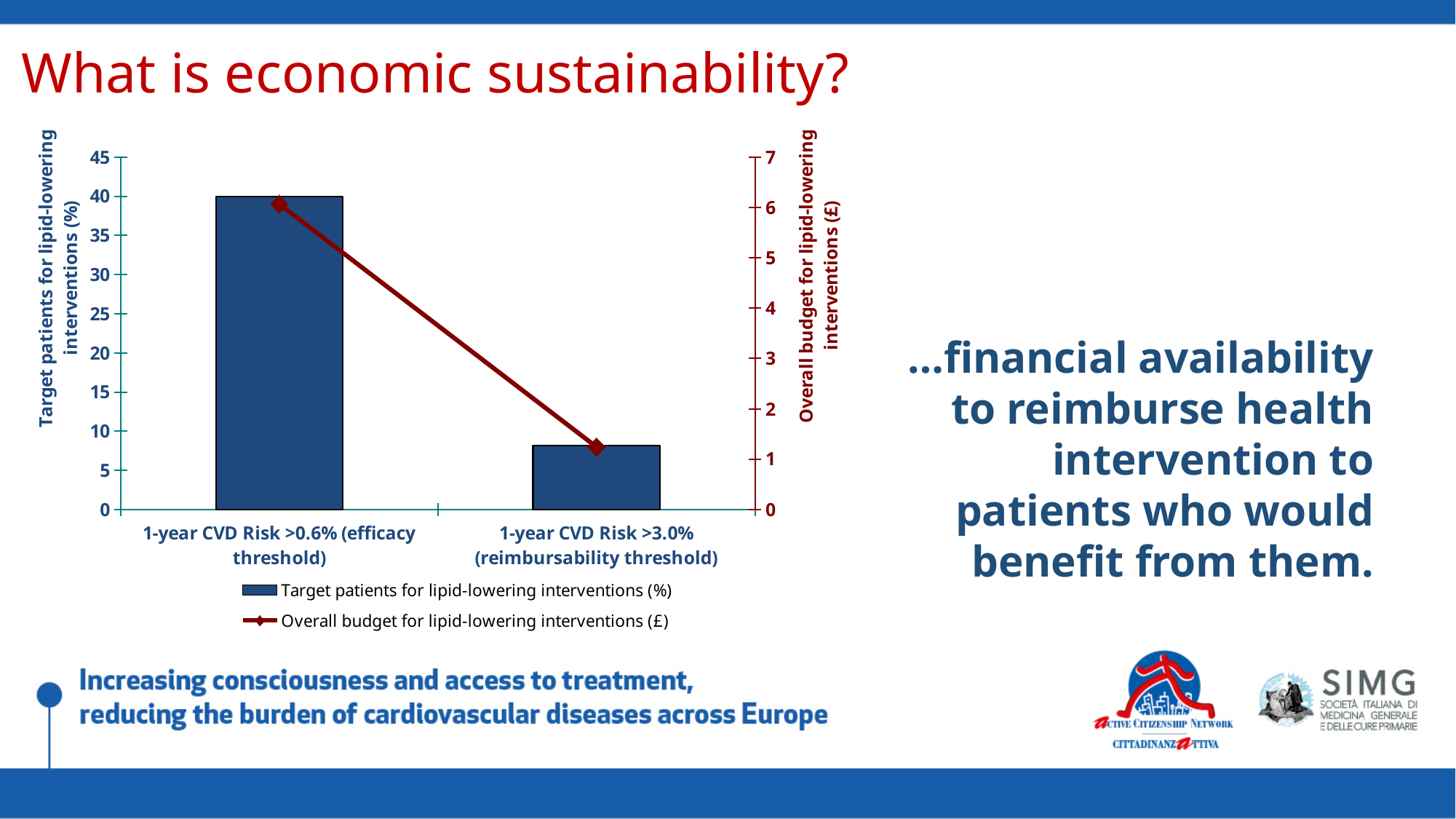
Which category has the highest Target patients for lipid-lowering interventions (%) value? 1-year CVD Risk >0.6% (efficacy threshold) Do the values of both series rise or fall from the >0.6% category to the >3.0% category? fall Is the Overall budget for lipid-lowering interventions (£) value for 1-year CVD Risk >3.0% (reimbursability threshold) greater or less than 2? less Which category has the lowest Overall budget for lipid-lowering interventions (£) value? 1-year CVD Risk >3.0% (reimbursability threshold) What is the title of the left vertical axis of the chart? Target patients for lipid-lowering interventions (%) Is the Overall budget for lipid-lowering interventions (£) value for 1-year CVD Risk >0.6% (efficacy threshold) greater or less than 5? greater How many series does the chart's legend list? 2 What kind of chart is shown on the slide? A bar chart combined with a line Which series in the legend is drawn as a line with markers? Overall budget for lipid-lowering interventions (£) Is the Target patients for lipid-lowering interventions (%) value for 1-year CVD Risk >3.0% (reimbursability threshold) greater or less than 10? less How many categories are shown on the x axis of the chart? 2 What is the value of the Target patients for lipid-lowering interventions (%) bar for 1-year CVD Risk >0.6% (efficacy threshold)? 40